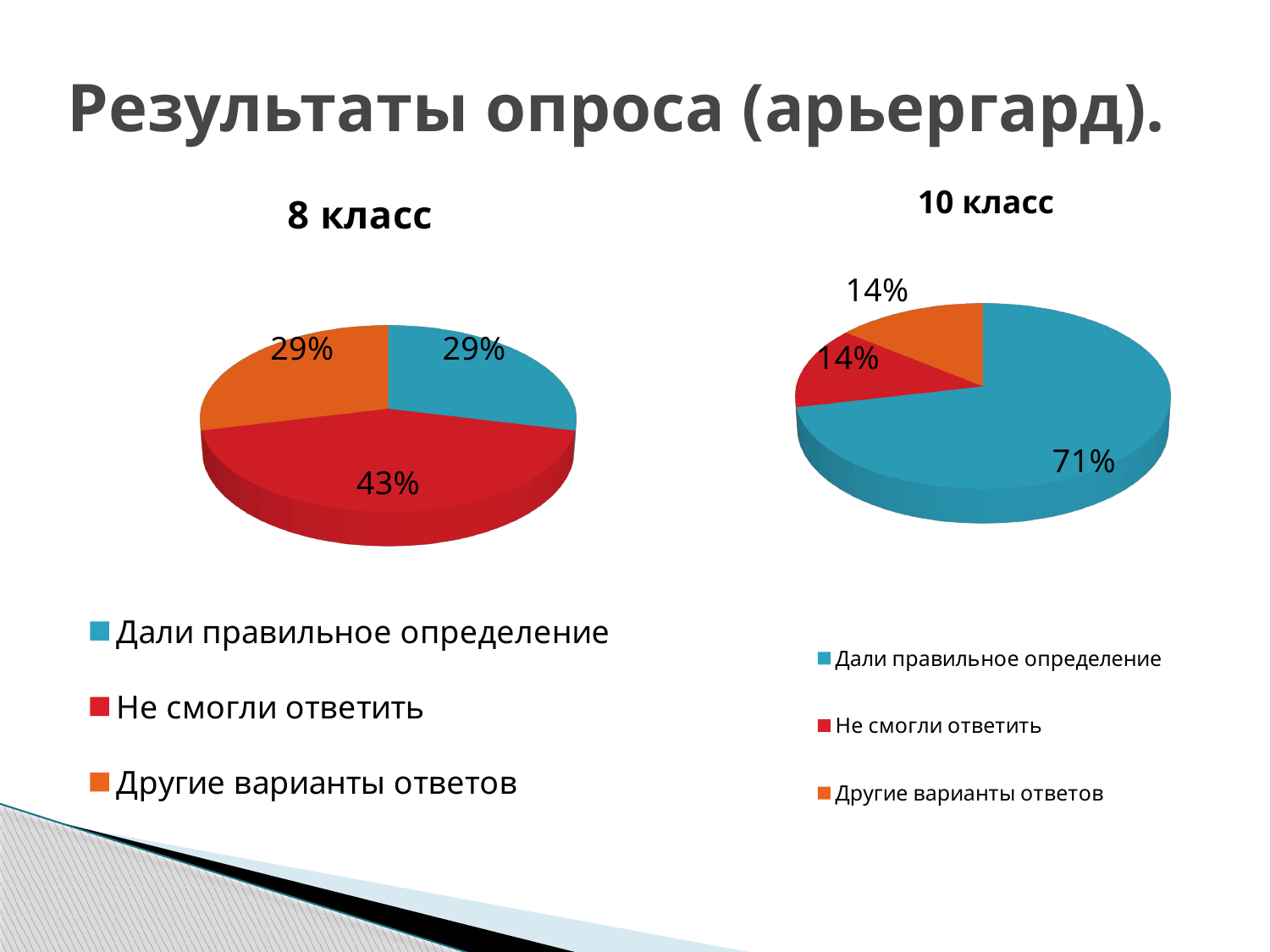
In the "8 класс" chart, what is the difference between the "Не смогли ответить" share and the "Дали правильное определение" share? 14% What type of chart is the "8 класс" chart? Pie chart In the "10 класс" chart, what share is labelled "Другие варианты ответов"? 14% In the "8 класс" chart, which category has the largest slice? Не смогли ответить How many slices does the "10 класс" chart have? 3 In the "10 класс" chart, what share is labelled "Дали правильное определение"? 71% In the "8 класс" chart, what share is labelled "Дали правильное определение"? 29% Which chart shows a larger share for "Дали правильное определение", "8 класс" or "10 класс"? 10 класс In the "8 класс" chart, what share of respondents is labelled "Не смогли ответить"? 43% In the "10 класс" chart, which category has the largest slice? Дали правильное определение In the "10 класс" chart, what is the difference between the "Дали правильное определение" share and the "Не смогли ответить" share? 57% How many entries does the legend of the "8 класс" chart list? 3